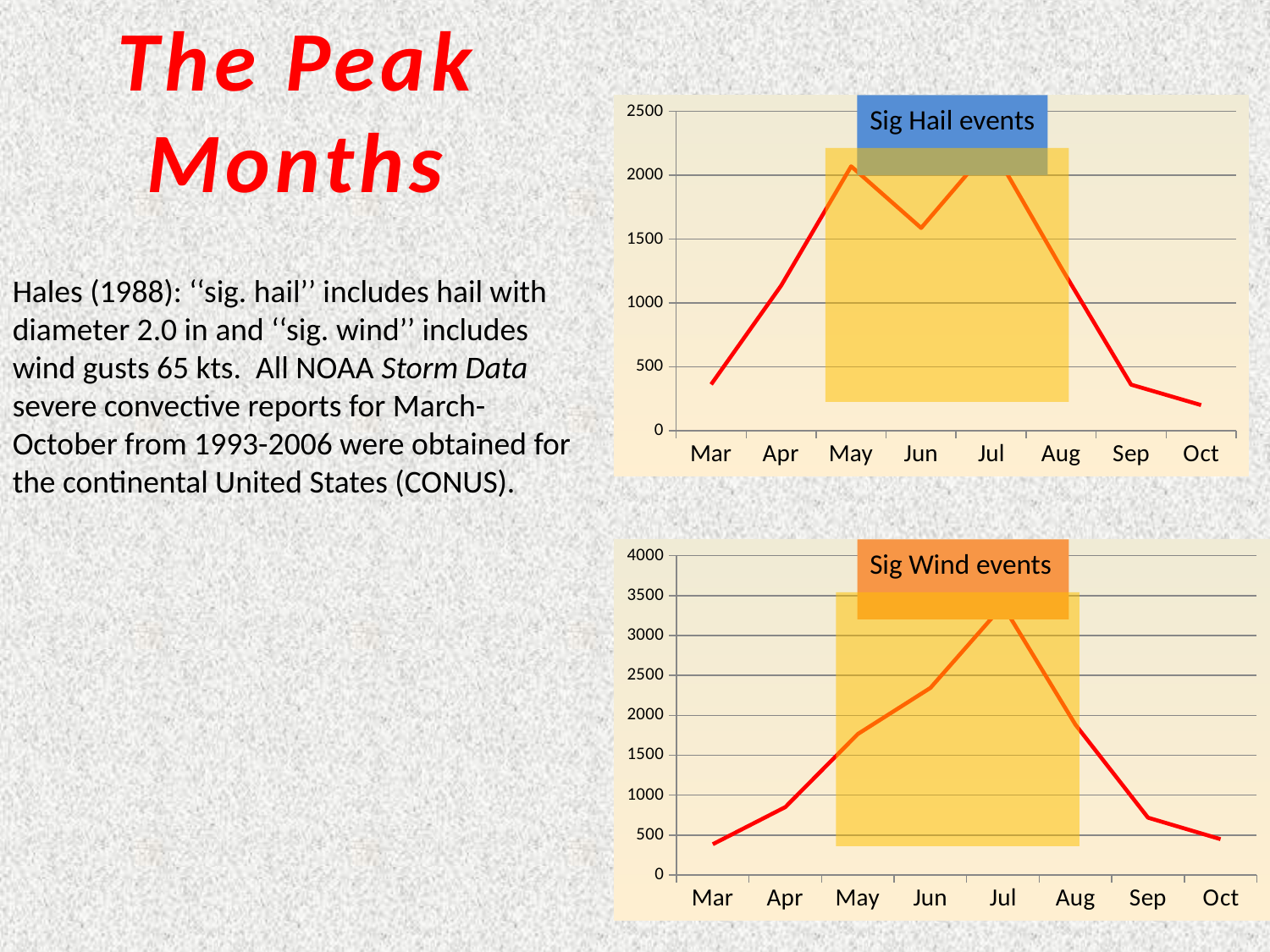
In the Sig Wind events chart, which is larger, the value for Jul or the value for Aug? Jul In the Sig Hail events chart, which is larger, the value for May or the value for Jun? May In the Sig Wind events chart, do the values rise or fall from Mar to Jul? rise In the Sig Wind events chart, is the value for Jul greater or less than 3000? greater In the Sig Hail events chart, is the value for Jun greater or less than 2000? less In the Sig Hail events chart, which month has the lowest value? Oct How many months are plotted on the x axis of the Sig Wind events chart? 8 In the Sig Hail events chart, is the value for Sep greater or less than 500? less What type of chart is the Sig Hail events chart? line chart In the Sig Wind events chart, which month has the highest value? Jul What is the title of the lower chart on the slide? Sig Wind events